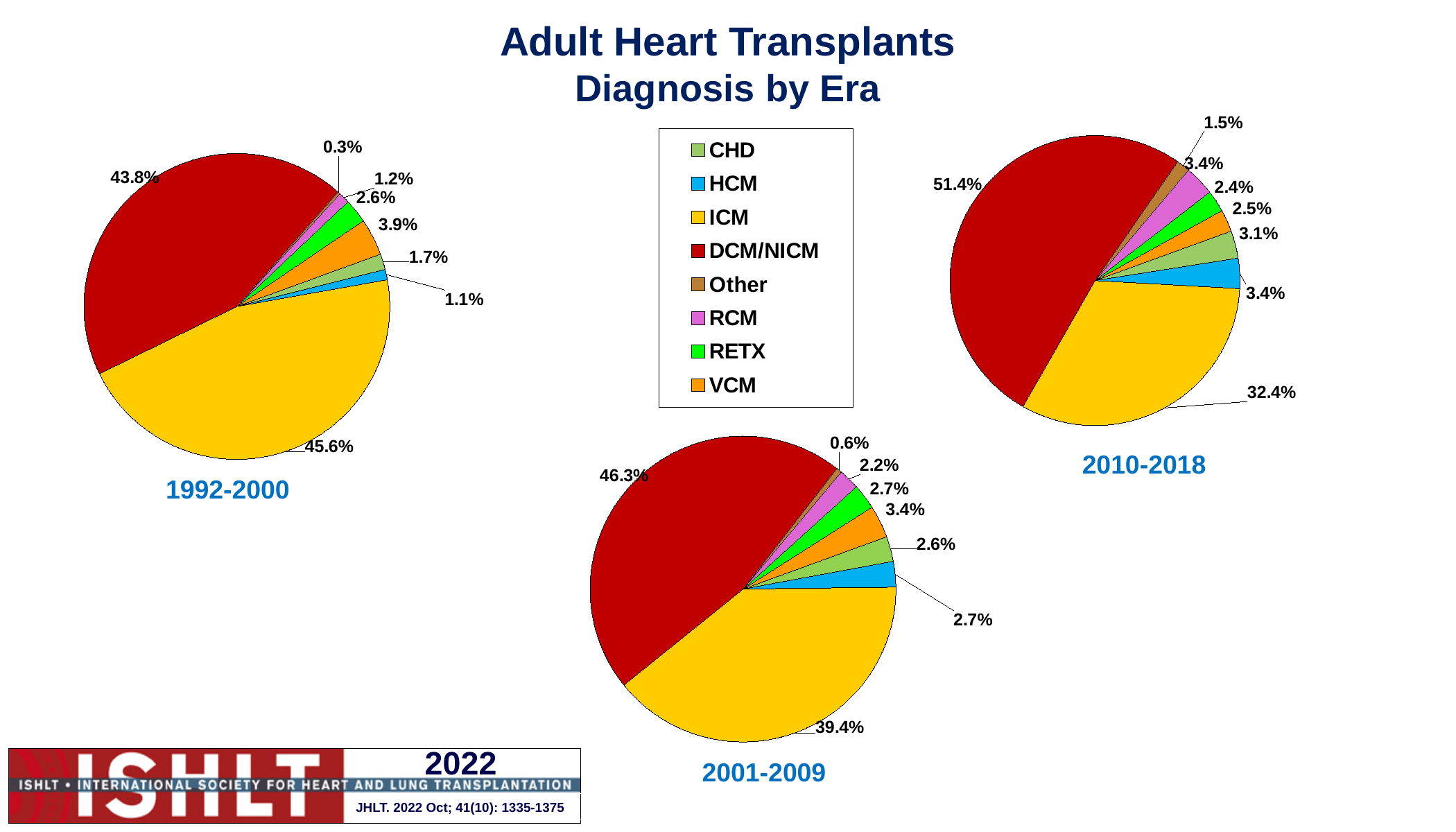
What type of chart is used on this slide? Pie chart In the 1992-2000 pie chart, which diagnosis has the smallest share? Other Which colour represents ICM in the legend? Yellow How does the ICM share change across the three eras from 1992-2000 to 2010-2018? It falls In the 2001-2009 pie chart, what percentage is shown for VCM? 3.4% How many diagnosis categories does the legend list? 8 In the 2010-2018 pie chart, what is the difference between the DCM/NICM share and the ICM share? 19.0% In the 1992-2000 pie chart, what share of adult heart transplants had an ICM diagnosis? 45.6% In the 2010-2018 pie chart, what percentage is shown for DCM/NICM? 51.4% In the 2010-2018 pie chart, what percentage is shown for the Other category? 1.5% In the 1992-2000 pie chart, which is larger, the ICM share or the DCM/NICM share? ICM In the 2001-2009 pie chart, which diagnosis has the largest share? DCM/NICM